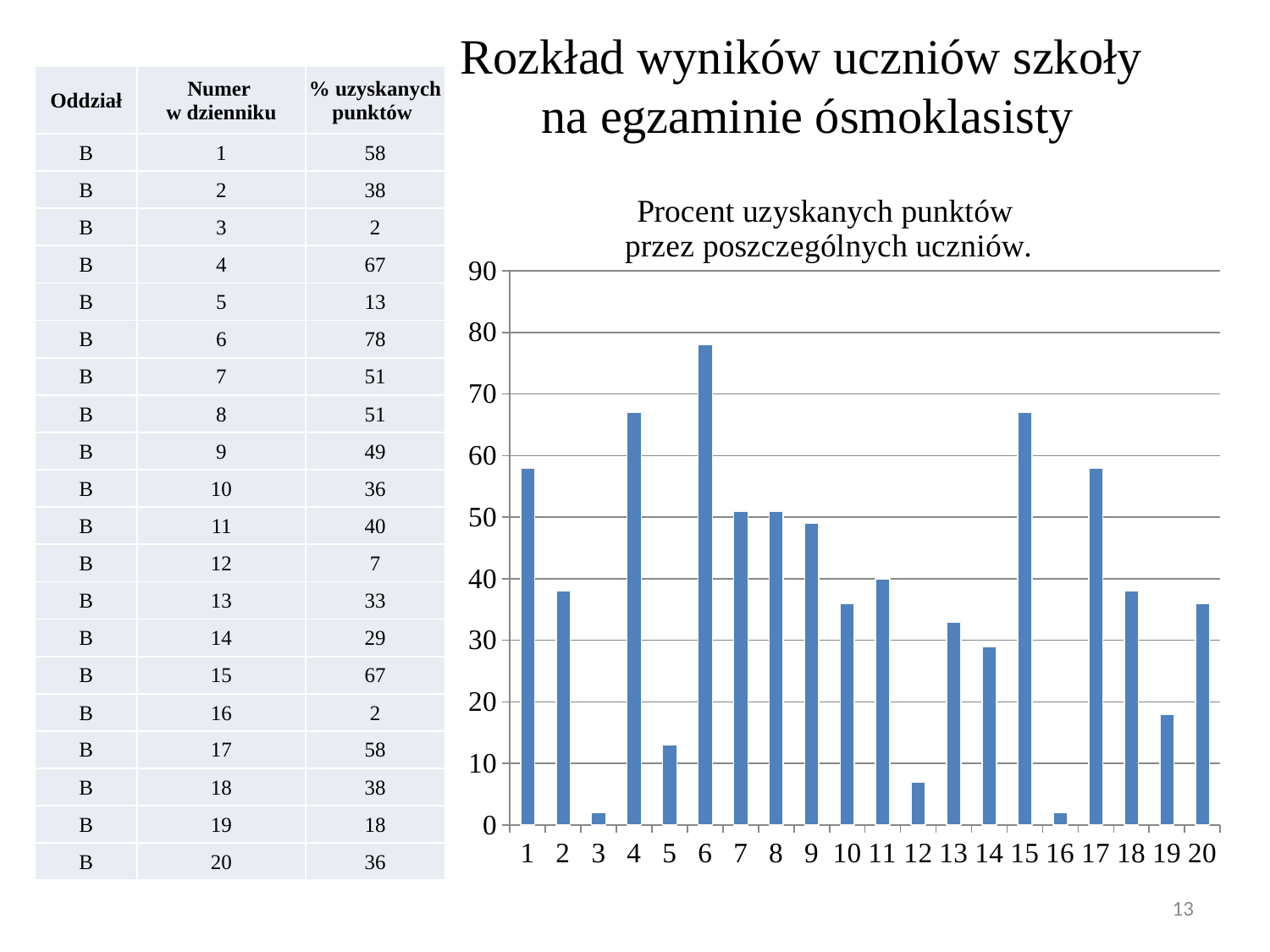
How many students (bars) are plotted in the chart? 20 Which is larger, the value for student 9 or the value for student 10? student 9 What is the title of the chart? Procent uzyskanych punktów przez poszczególnych uczniów. Is the value for student 12 greater or less than 10? less What percentage of points did student number 4 obtain? 67 What percentage of points did student number 6 obtain? 78 What is the highest value shown on the vertical axis of the chart? 90 What kind of chart is shown on the slide? bar chart Which student number has the highest percentage of points in the chart? 6 Which students have the lowest value in the chart? 3 and 16 What is the difference between the values for student 6 and student 5? 65 Is the value for student 17 greater or less than 50? greater